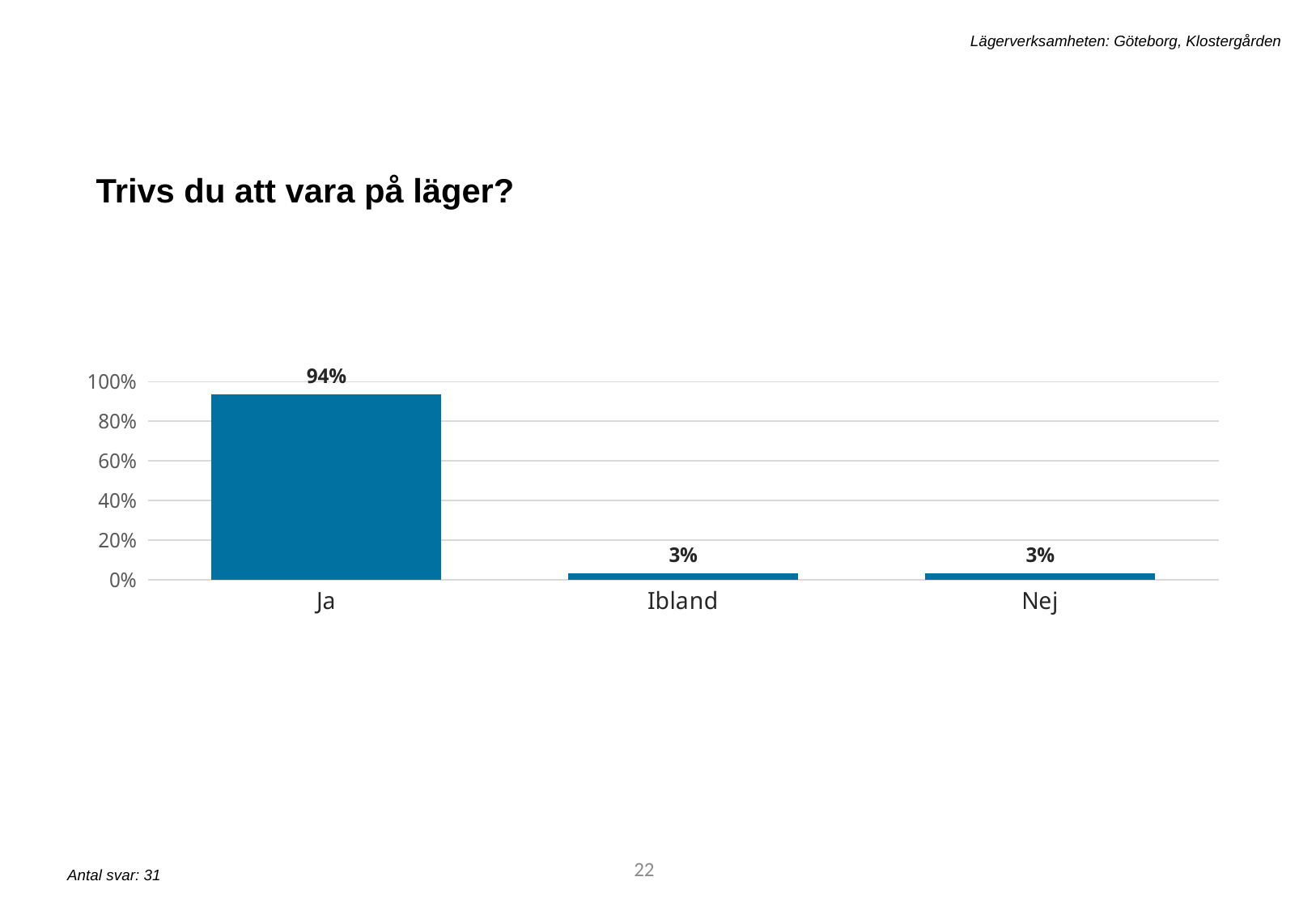
What is the difference between the values for Ja and Ibland? 91% Which is larger, the value for Ja or the value for Nej? Ja What is the highest tick value shown on the y axis? 100% How many categories are shown on the x axis? 3 What kind of chart is shown on the slide? bar chart What is the value for Ja? 94% What is the value for Ibland? 3% What is the title of the slide above the chart? Trivs du att vara på läger? Is the value for Ibland greater or less than 20%? less Is the value for Ja greater or less than 80%? greater What is the value for Nej? 3% Which category has the highest value? Ja